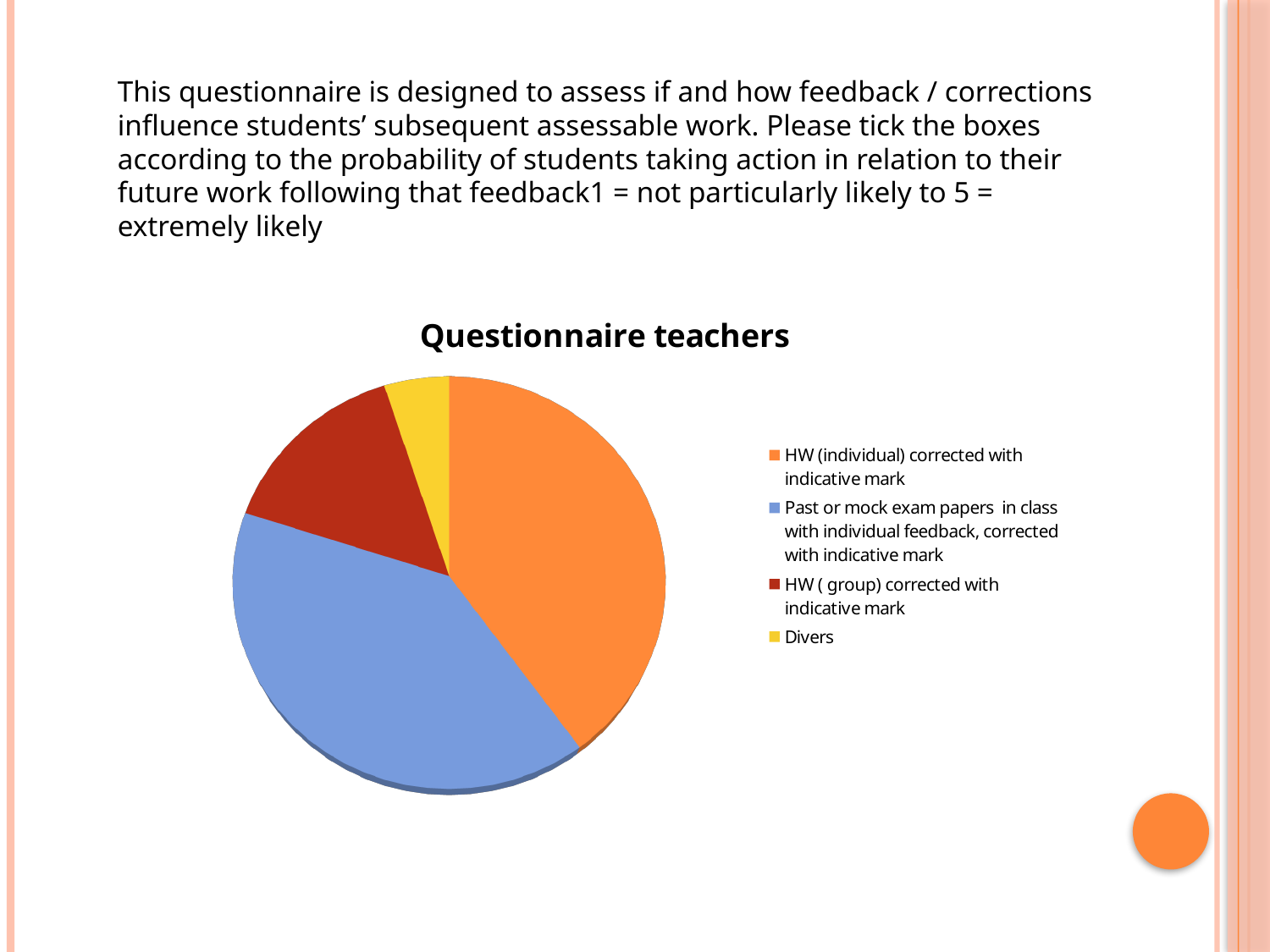
How many entries does the legend list? 4 What is the title of the chart? Questionnaire teachers Which slice is larger: "Past or mock exam papers in class with individual feedback, corrected with indicative mark" or "Divers"? Past or mock exam papers in class with individual feedback, corrected with indicative mark Which category has the smallest slice of the pie? Divers What colour is the slice for "Divers"? yellow What kind of chart is shown on the slide? pie chart How many slices does the pie chart have? 4 Which slice is larger: "HW ( group) corrected with indicative mark" or "Divers"? HW ( group) corrected with indicative mark Which slice is larger: "HW (individual) corrected with indicative mark" or "HW ( group) corrected with indicative mark"? HW (individual) corrected with indicative mark